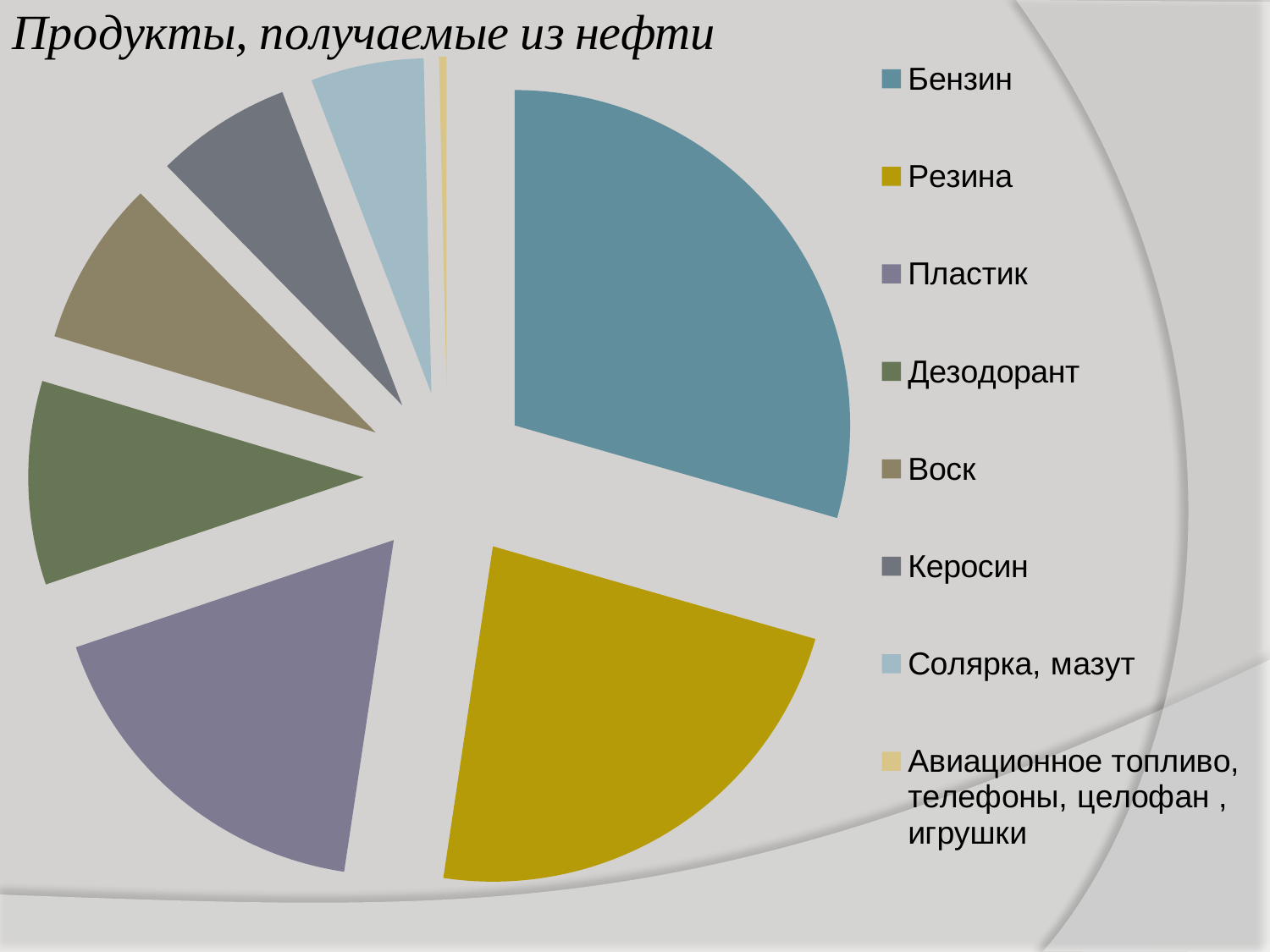
What is the title of the chart? Продукты, получаемые из нефти Which slice is larger, Дезодорант or Солярка, мазут? Дезодорант How many categories (slices) does the pie chart have? 8 Which slice is larger, Керосин or Резина? Резина What kind of chart is shown on the slide? pie chart Which category has the smallest slice of the pie? Авиационное топливо, телефоны, целофан, игрушки What colour is the slice for Резина? yellow (olive-gold) Which category has the largest slice of the pie? Бензин How many entries does the legend list? 8 Which slice is larger, Бензин or Резина? Бензин Which category is the second-largest slice of the pie? Резина